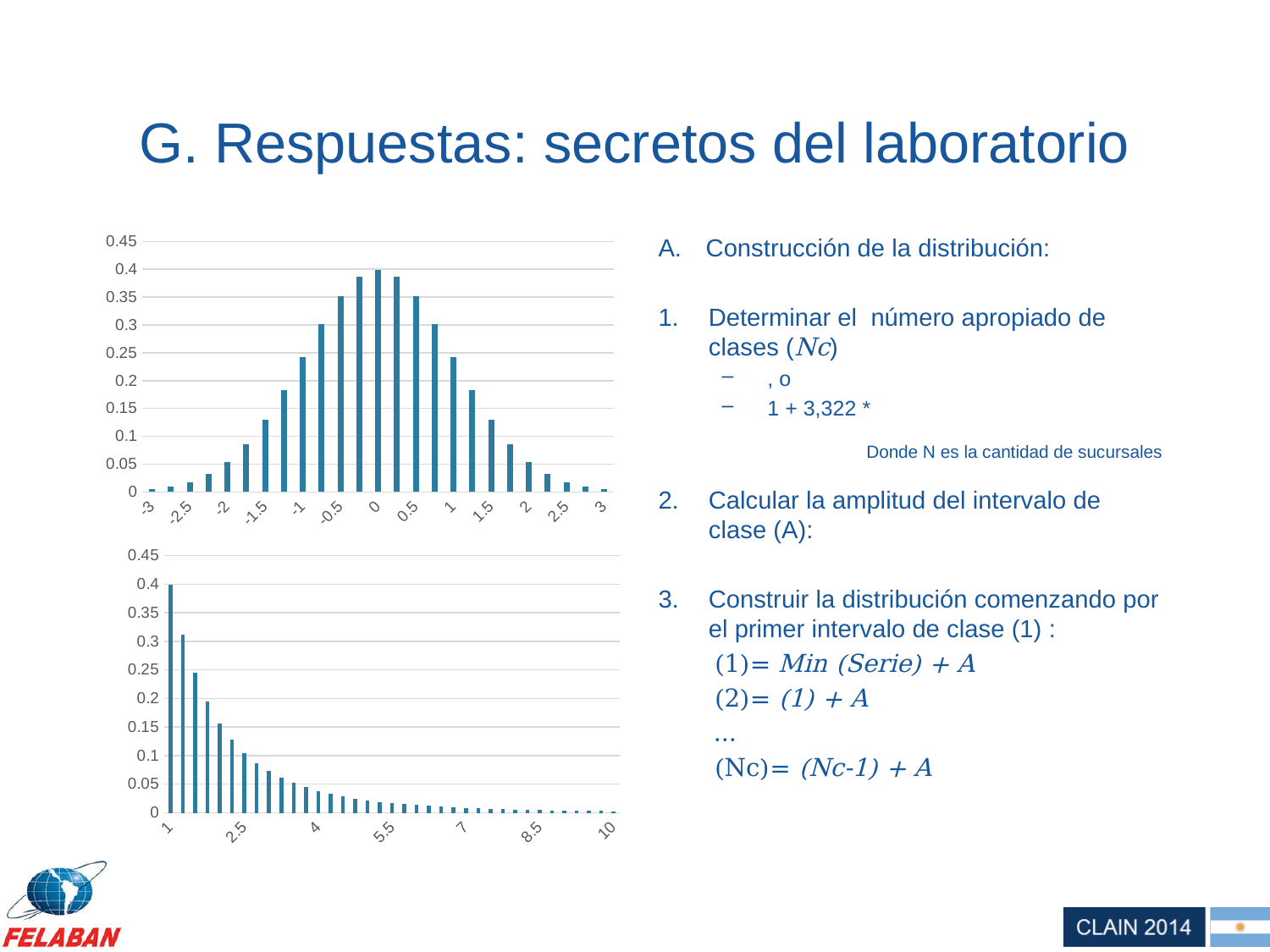
In the top chart, which x-axis category has the highest bar? 0 What kind of chart is the bottom chart on the slide? bar chart In the top chart, do the values rise or fall as the x axis goes from -3 to 0? rise In the bottom chart, which x-axis category has the highest bar? 1 In the top chart, is the value at 0 greater or less than 0.35? greater In the top chart, which is larger, the value at -0.5 or the value at -1.5? -0.5 What kind of chart is the top chart on the slide? bar chart In the bottom chart, which is larger, the value at 2.5 or the value at 7? 2.5 In the top chart, is the value at -3 greater or less than 0.05? less In the bottom chart, do the values rise or fall as the x axis goes from 1 to 10? fall In the bottom chart, is the value at 1 greater or less than 0.35? greater